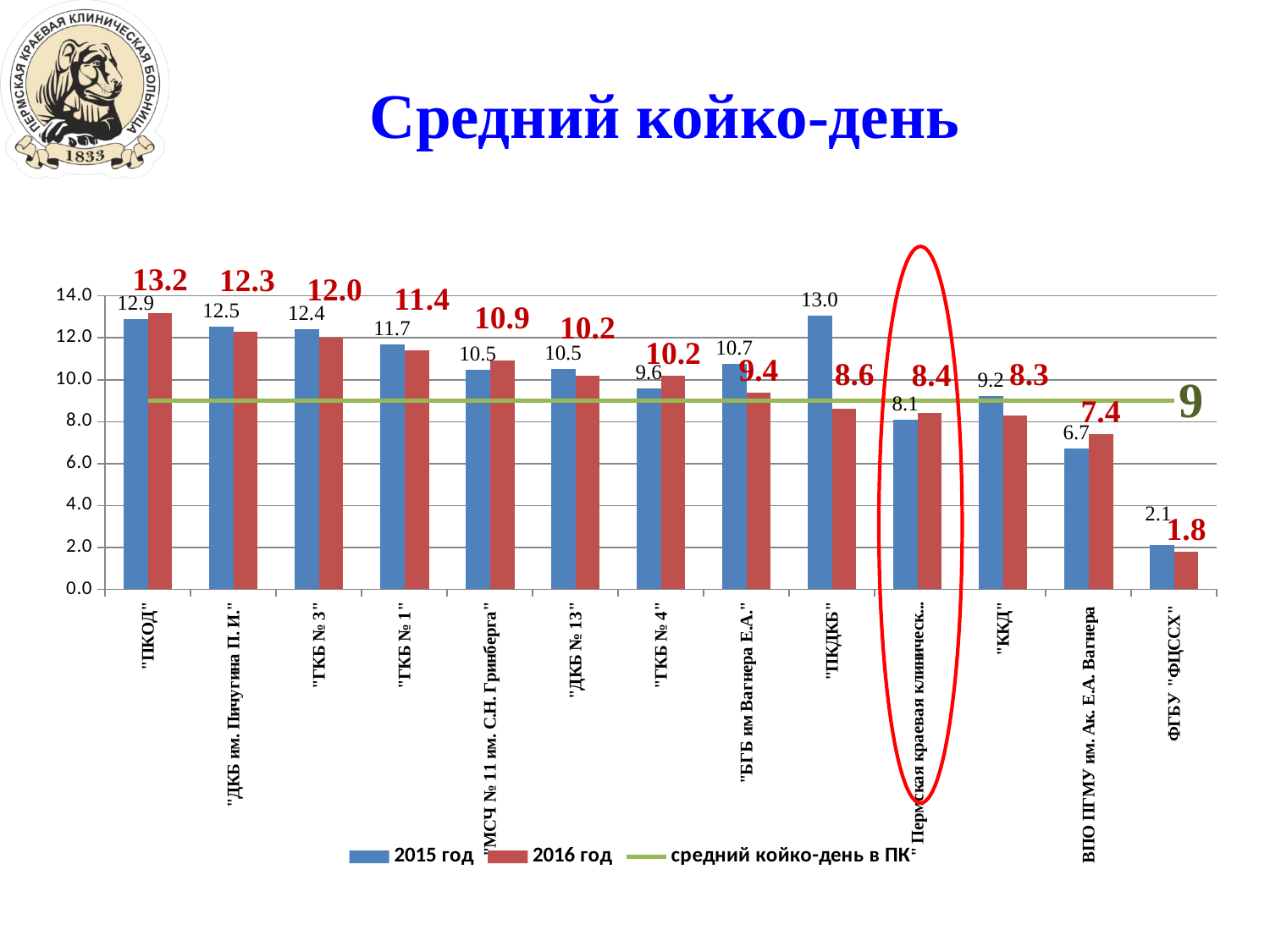
What is the difference between the 2015 год and 2016 год values for "ПКДКБ"? 4.4 What is the 2015 год value for "ПКДКБ"? 13.0 Which category has the highest 2016 год value? "ПКОД" Which category has the lowest 2015 год value? ФГБУ "ФЦССХ" What is the 2016 год value for "ПКОД"? 13.2 How many entries does the legend list? 3 What value does the line "средний койко-день в ПК" show? 9 What kind of chart is shown on the slide? bar chart Is the 2016 год value for "ВПО ПГМУ им. Ак. Е.А. Вагнера" greater or less than 8.0? less Which is larger for "ГКБ № 4": the 2015 год value or the 2016 год value? 2016 год How many categories are shown on the x axis? 13 What is the 2016 год value for "ККД"? 8.3